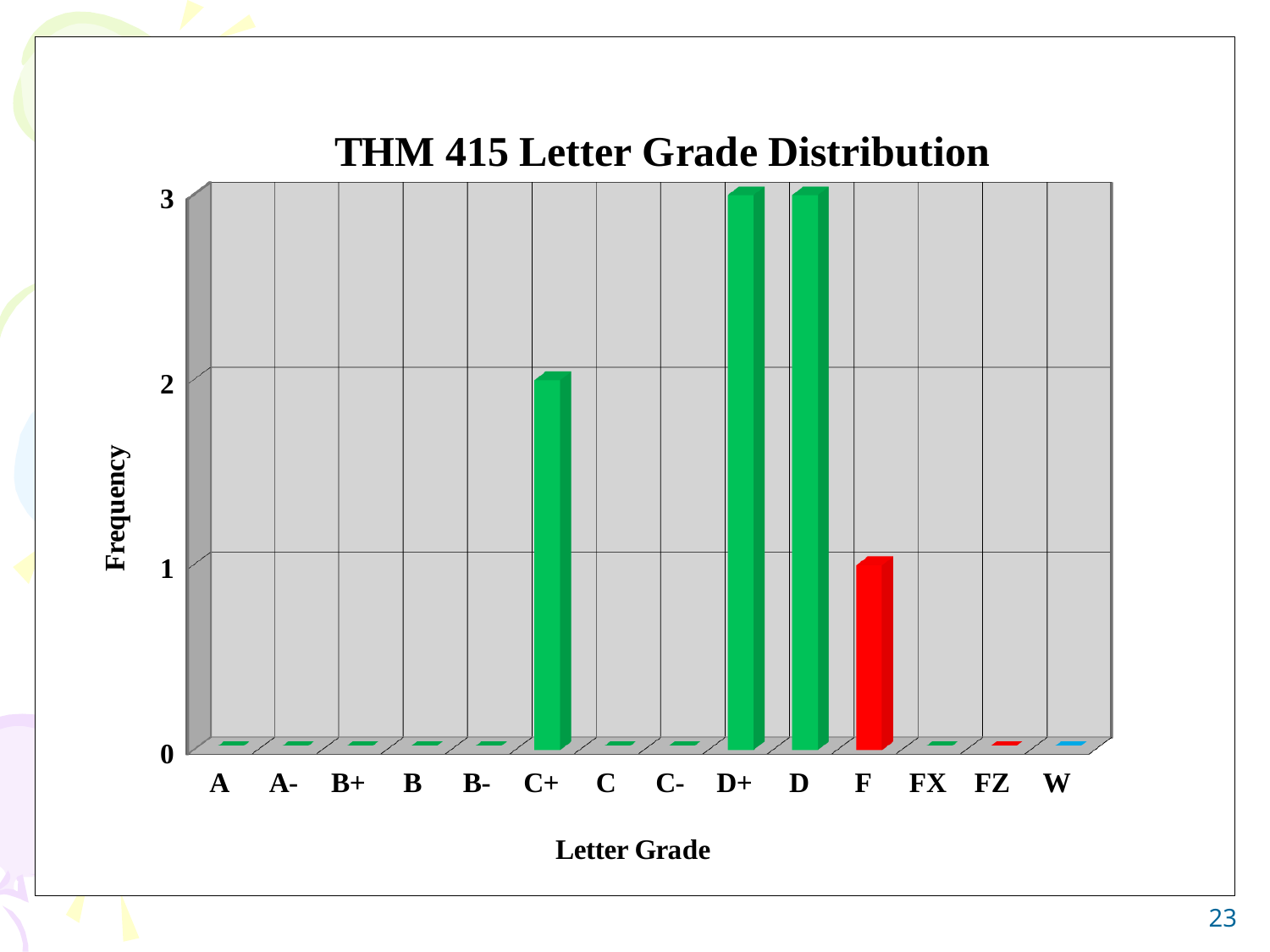
What is the frequency for the letter grade A? 0 Which has the larger frequency, C+ or F? C+ What label is shown on the y axis? Frequency What is the frequency for the letter grade D+? 3 How many letter grades have a frequency greater than 0? 4 Is the frequency for D+ greater or less than 2? greater What kind of chart is shown on the slide? bar chart What is the frequency for the letter grade F? 1 What is the title of the chart? THM 415 Letter Grade Distribution What is the frequency for the letter grade C+? 2 How many letter grade categories are shown on the x axis? 14 What is the difference between the frequency for D and the frequency for C+? 1